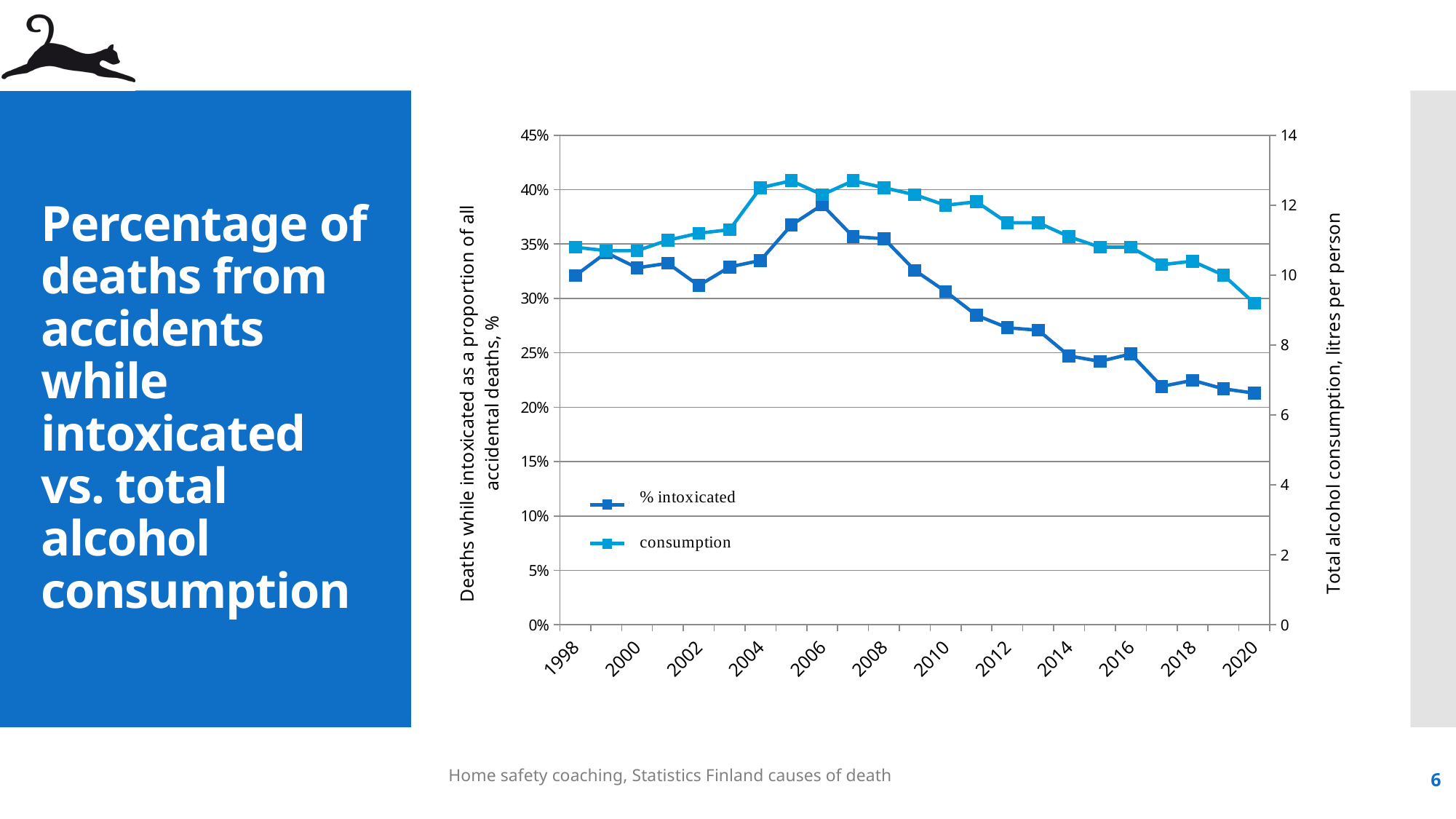
In which year is the consumption series at its lowest value? 2020 What are the two series named in the legend? % intoxicated and consumption Is the consumption value in 2020 greater or less than 10 litres per person? less Which is larger: the % intoxicated value in 2006 or in 1998? 2006 Does the % intoxicated series rise or fall between 2006 and 2020? Fall How many series does the chart's legend list? 2 Is the value for % intoxicated in 2006 greater or less than 35%? greater What kind of chart is shown on the slide? Line chart In which year does the % intoxicated series reach its highest value? 2006 What is the title of the right-hand vertical axis? Total alcohol consumption, litres per person Is the value for % intoxicated in 2020 greater or less than 25%? less How many year labels are shown on the x axis? 12